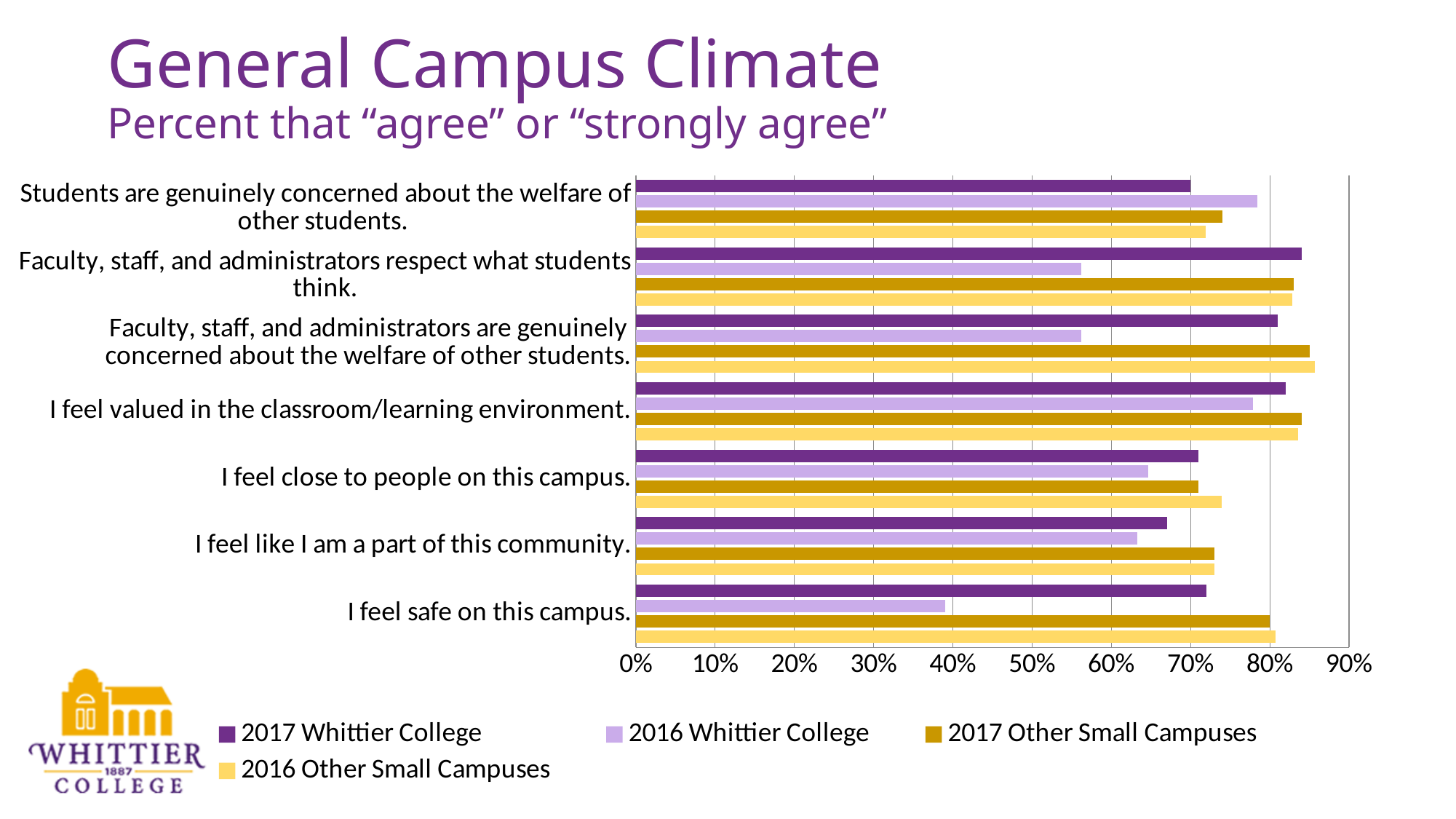
Which statement has the lowest 2016 Whittier College value? I feel safe on this campus. Is the 2017 Whittier College value for "Faculty, staff, and administrators respect what students think." greater or less than 80%? greater Is the 2017 Whittier College value for "I feel like I am a part of this community." greater or less than 70%? less What is the subtitle of the slide beneath "General Campus Climate"? Percent that "agree" or "strongly agree" Is the 2016 Other Small Campuses value for "Faculty, staff, and administrators are genuinely concerned about the welfare of other students." greater or less than 80%? greater What kind of chart is shown on the slide? Bar chart For "Students are genuinely concerned about the welfare of other students.", which is larger: the 2016 Whittier College value or the 2017 Whittier College value? 2016 Whittier College What colour represents the 2017 Whittier College series? Purple For "I feel safe on this campus.", which is larger: the 2017 Whittier College value or the 2016 Whittier College value? 2017 Whittier College How many series does the legend list? 4 How many statements (categories) are plotted on the chart? 7